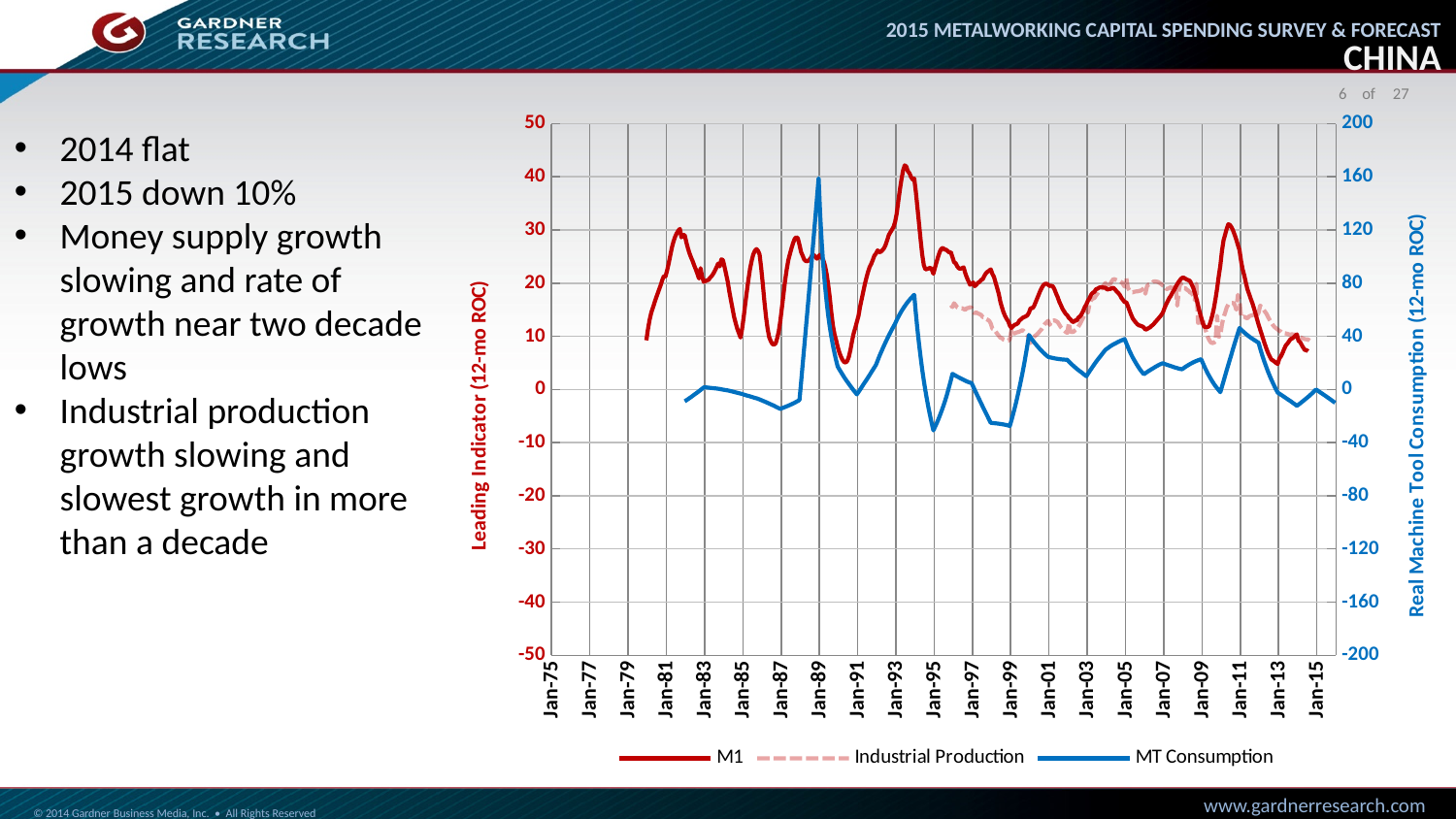
What is the title of the left vertical axis of the chart? Leading Indicator (12-mo ROC) Does the Industrial Production line rise or fall between Jan-11 and Jan-15? fall What kind of chart is shown on the slide? line chart Is the peak value of the MT Consumption line at Jan-89 greater or less than 120 on the right axis? greater How many year labels are shown along the x axis of the chart? 21 Is the value of the MT Consumption line around Jan-95 greater or less than 0 on the right axis? less What are the three series named in the chart legend? M1, Industrial Production, MT Consumption Is the value of the M1 line around Jan-13 greater or less than 10 on the left axis? less Which is larger, the M1 value around Jan-93 or the M1 value around Jan-99? Jan-93 How many series does the chart legend list? 3